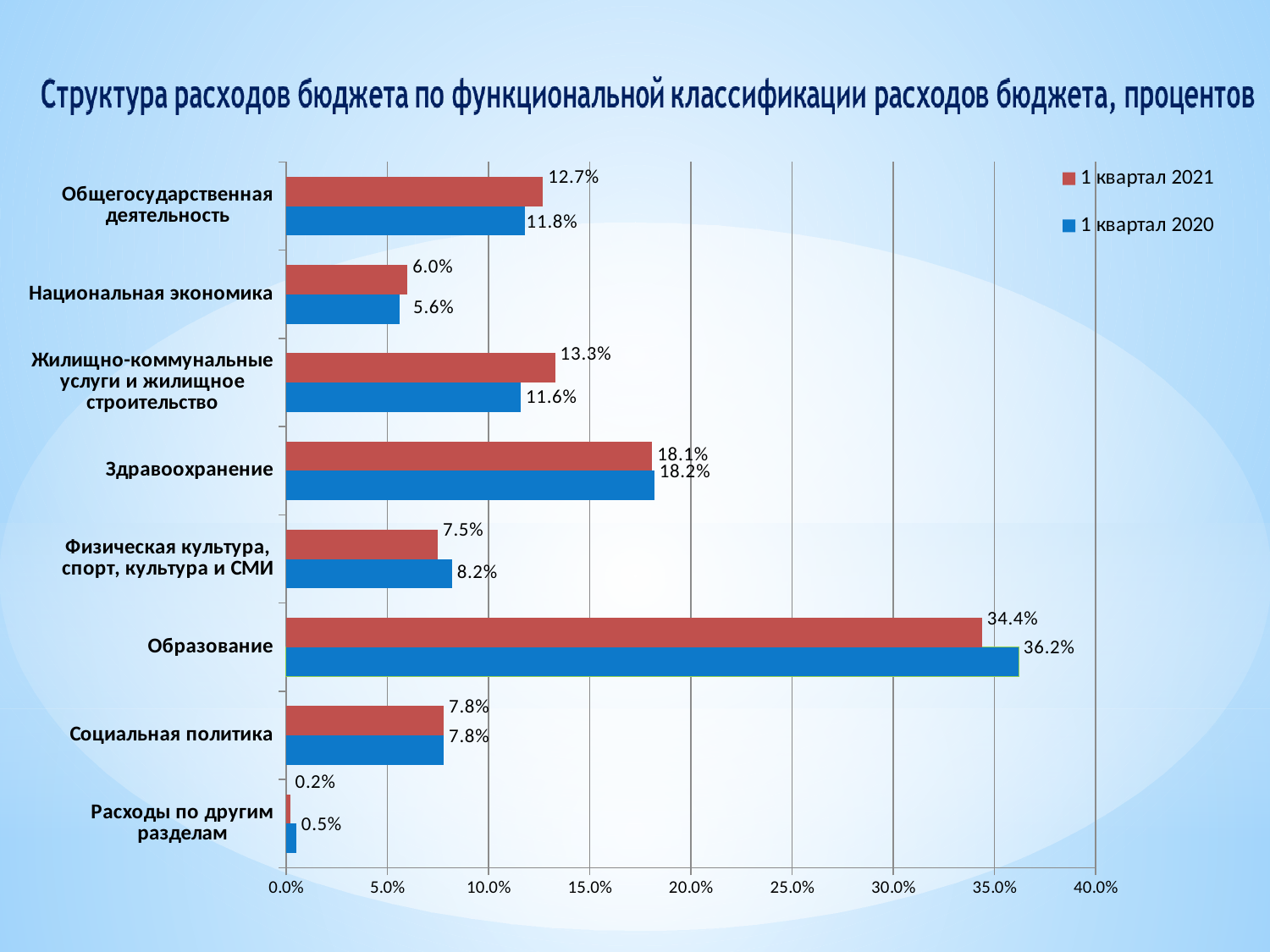
What is the value for Образование in the 1 квартал 2020 series? 36.2% What is the difference between the 1 квартал 2020 and 1 квартал 2021 values for Образование? 1.8% Is the 1 квартал 2021 value for Общегосударственная деятельность greater or less than 10.0%? greater Which is larger for Жилищно-коммунальные услуги и жилищное строительство: the 1 квартал 2021 value or the 1 квартал 2020 value? 1 квартал 2021 What is the value for Здравоохранение in the 1 квартал 2021 series? 18.1% Which colour represents the 1 квартал 2020 series? blue Which category has the lowest value in the 1 квартал 2020 series? Расходы по другим разделам How many categories are shown on the chart? 8 Which category has the highest value in the 1 квартал 2021 series? Образование What is the value for Национальная экономика in the 1 квартал 2020 series? 5.6% What kind of chart is shown on the slide? bar chart How many series does the legend list? 2